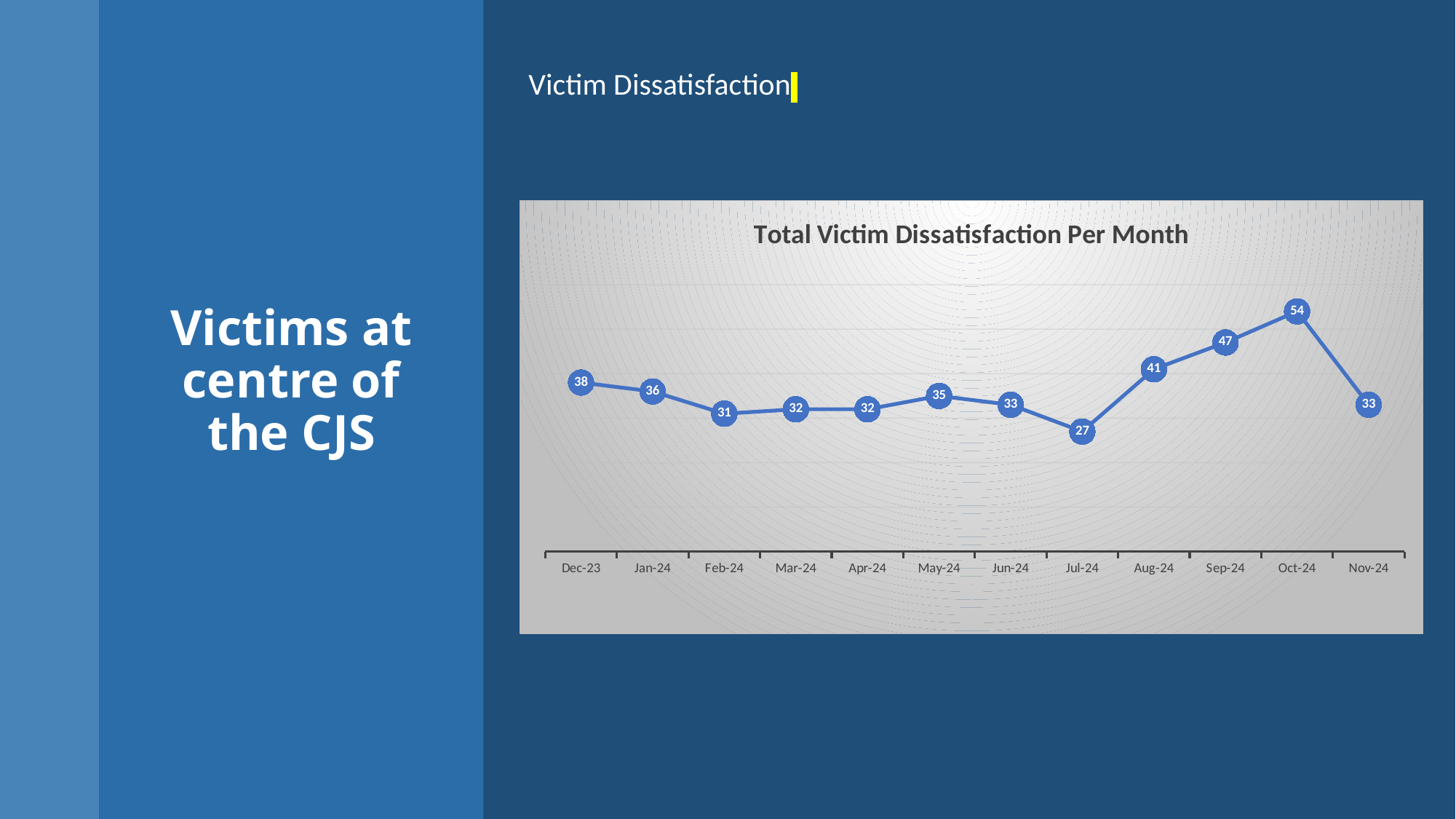
What is the title of the chart? Total Victim Dissatisfaction Per Month How many months are plotted on the chart? 12 What is the value for Oct-24? 54 What is the difference between the values for Oct-24 and Jul-24? 27 What is the value for Jul-24? 27 What is the value for Dec-23? 38 What is the difference between the values for Sep-24 and Aug-24? 6 Which is larger, the value for Jan-24 or the value for Nov-24? Jan-24 What kind of chart is shown? Line chart Which month has the highest value? Oct-24 Which month has the lowest value? Jul-24 Do the values rise or fall from Jul-24 to Oct-24? Rise